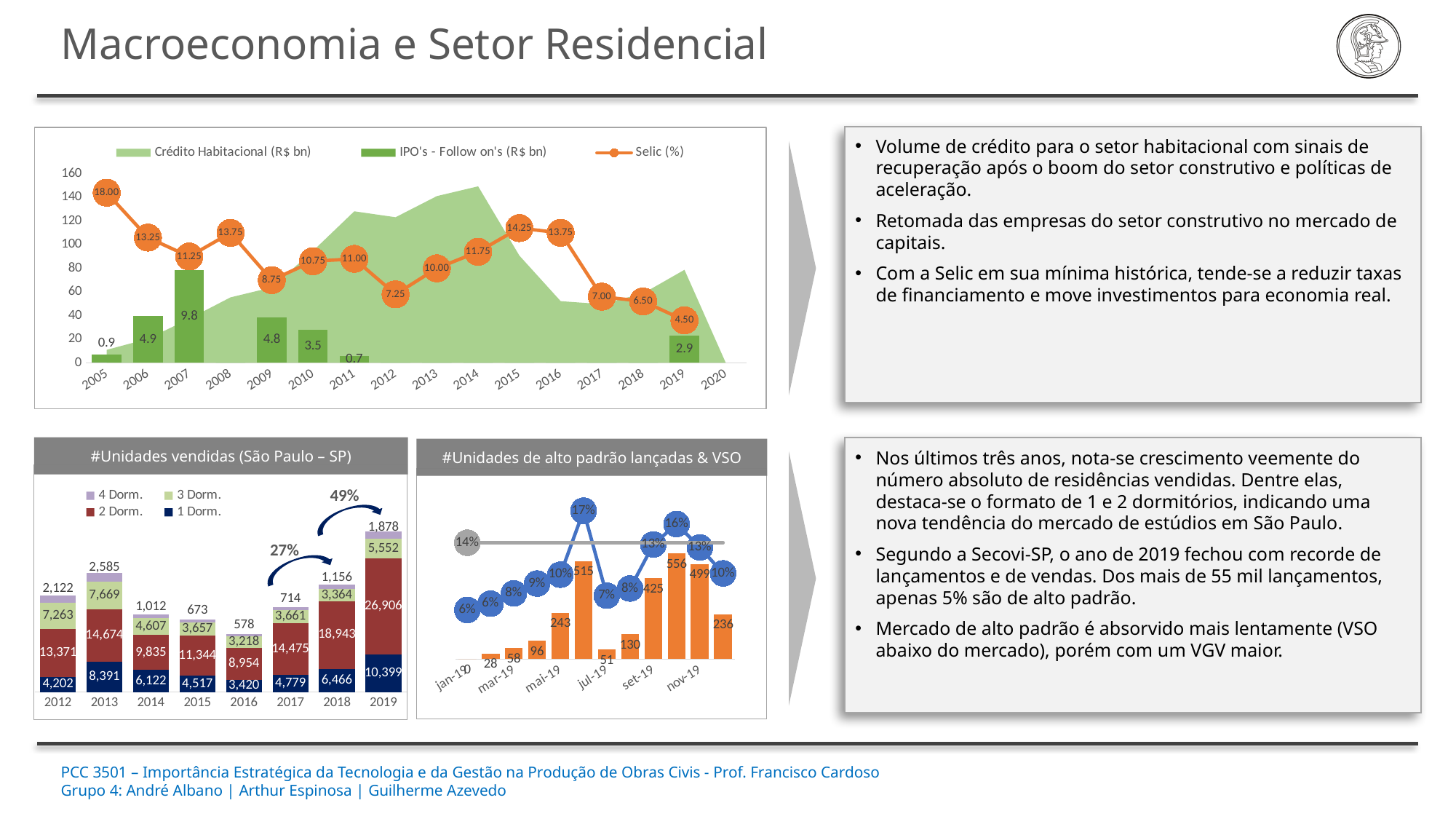
In the top-left chart, how many series does the legend list? 3 In the top-left chart, which year has the highest Selic (%) value? 2005 In the '#Unidades vendidas (São Paulo – SP)' chart, which is larger: the 3 Dorm. value for 2013 or for 2019? 2013 In the top-left chart, what is the difference between the Selic (%) values for 2015 and 2016? 0.50 In the '#Unidades de alto padrão lançadas & VSO' chart, what is the highest VSO percentage on the line? 17% In the '#Unidades vendidas (São Paulo – SP)' chart, how many years are shown on the x axis? 8 In the top-left chart, what is the IPO's - Follow on's (R$ bn) value for 2007? 9.8 In the top-left chart, what is the Selic (%) value for 2005? 18.00 In the top-left chart, what is the Selic (%) value for 2019? 4.50 In the '#Unidades vendidas (São Paulo – SP)' chart, what is the 2 Dorm. value for 2019? 26,906 In the '#Unidades de alto padrão lançadas & VSO' chart, what is the highest bar value? 556 In the '#Unidades vendidas (São Paulo – SP)' chart, what is the 1 Dorm. value for 2016? 3,420